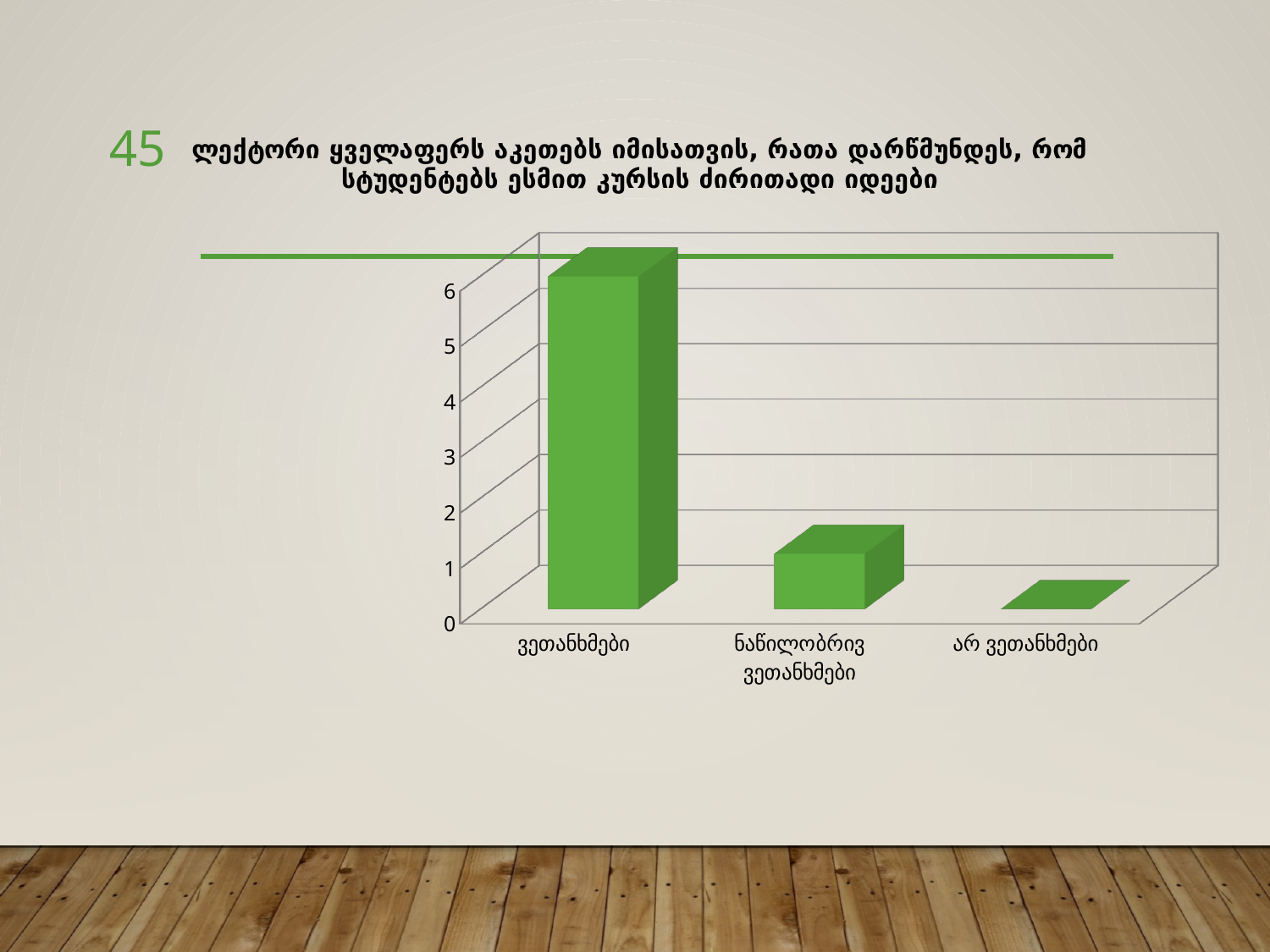
How many categories are shown on the x axis of the chart? 3 Is the value for ვეთანხმები greater or less than 5? greater Which is larger, the value for ვეთანხმები or the value for ნაწილობრივ ვეთანხმები? ვეთანხმები Is the value for ნაწილობრივ ვეთანხმები greater or less than 3? less Which category has the lowest bar? არ ვეთანხმები Which is larger, the value for ნაწილობრივ ვეთანხმები or the value for არ ვეთანხმები? ნაწილობრივ ვეთანხმები What is the highest tick value shown on the vertical axis? 6 Is the value for არ ვეთანხმები greater or less than 1? less Which category has the highest bar? ვეთანხმები What kind of chart is shown on the slide? bar chart What colour are the bars in the chart? green Do the bar values rise or fall from left to right along the x axis? fall